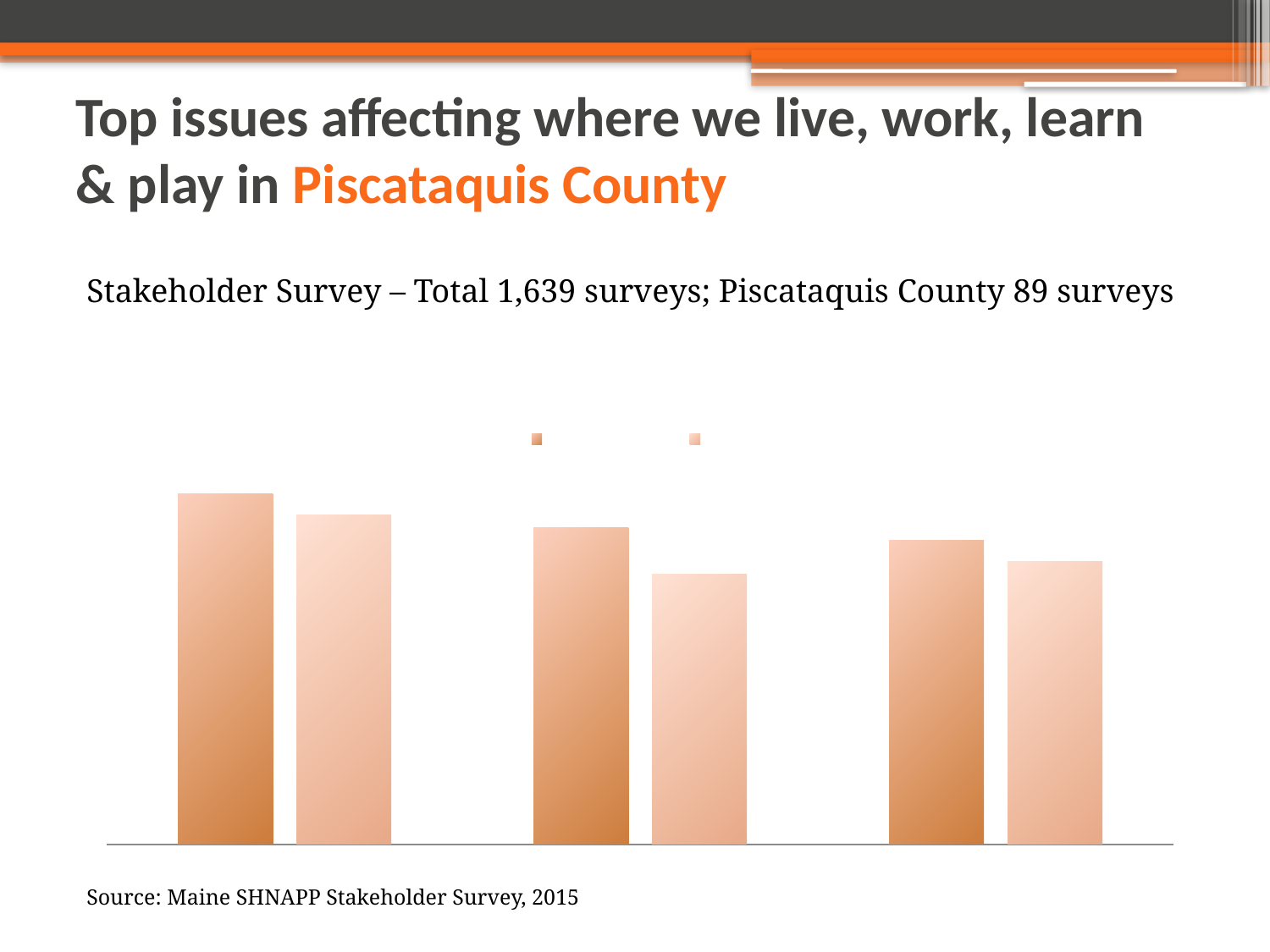
What kind of chart is shown on the slide? bar chart In each group of bars, is the left (darker) bar taller or shorter than the right (lighter) bar? taller How many groups of bars are plotted in the chart? 3 Which group of bars contains the tallest bar in the chart: the leftmost, middle, or rightmost group? leftmost Do the darker bars rise or fall from left to right across the three groups? fall How many series does the chart's legend list? 2